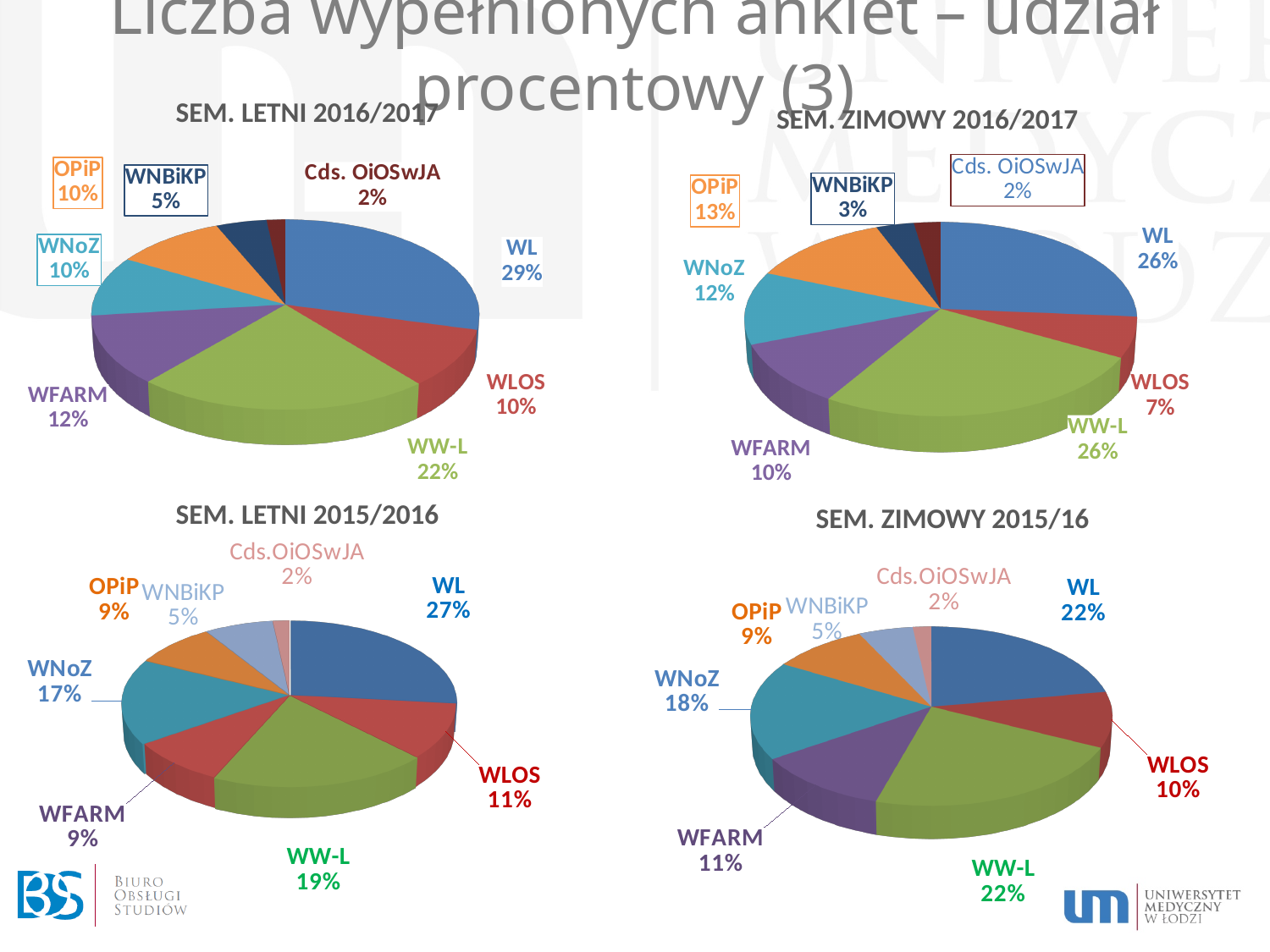
In the SEM. LETNI 2015/2016 chart, what share does WNoZ have? 17% How many categories does the SEM. ZIMOWY 2015/16 chart show? 8 In the SEM. ZIMOWY 2016/2017 chart, what share does OPiP have? 13% In the SEM. ZIMOWY 2016/2017 chart, what is the difference between the shares of WNoZ and WLOS? 5% In the SEM. LETNI 2015/2016 chart, which is larger, the share of WW-L or the share of WLOS? WW-L In the SEM. ZIMOWY 2016/2017 chart, which category has the smallest share? Cds. OiOSwJA What type of chart is the SEM. LETNI 2016/2017 chart? Pie chart In the SEM. LETNI 2016/2017 chart, which category has the largest share? WL In the SEM. ZIMOWY 2015/16 chart, what is the difference between the shares of WNoZ and OPiP? 9% In the SEM. ZIMOWY 2015/16 chart, what share does WFARM have? 11% In the SEM. LETNI 2016/2017 chart, what share does WL have? 29% In the SEM. LETNI 2016/2017 chart, which category has the smallest share? Cds. OiOSwJA